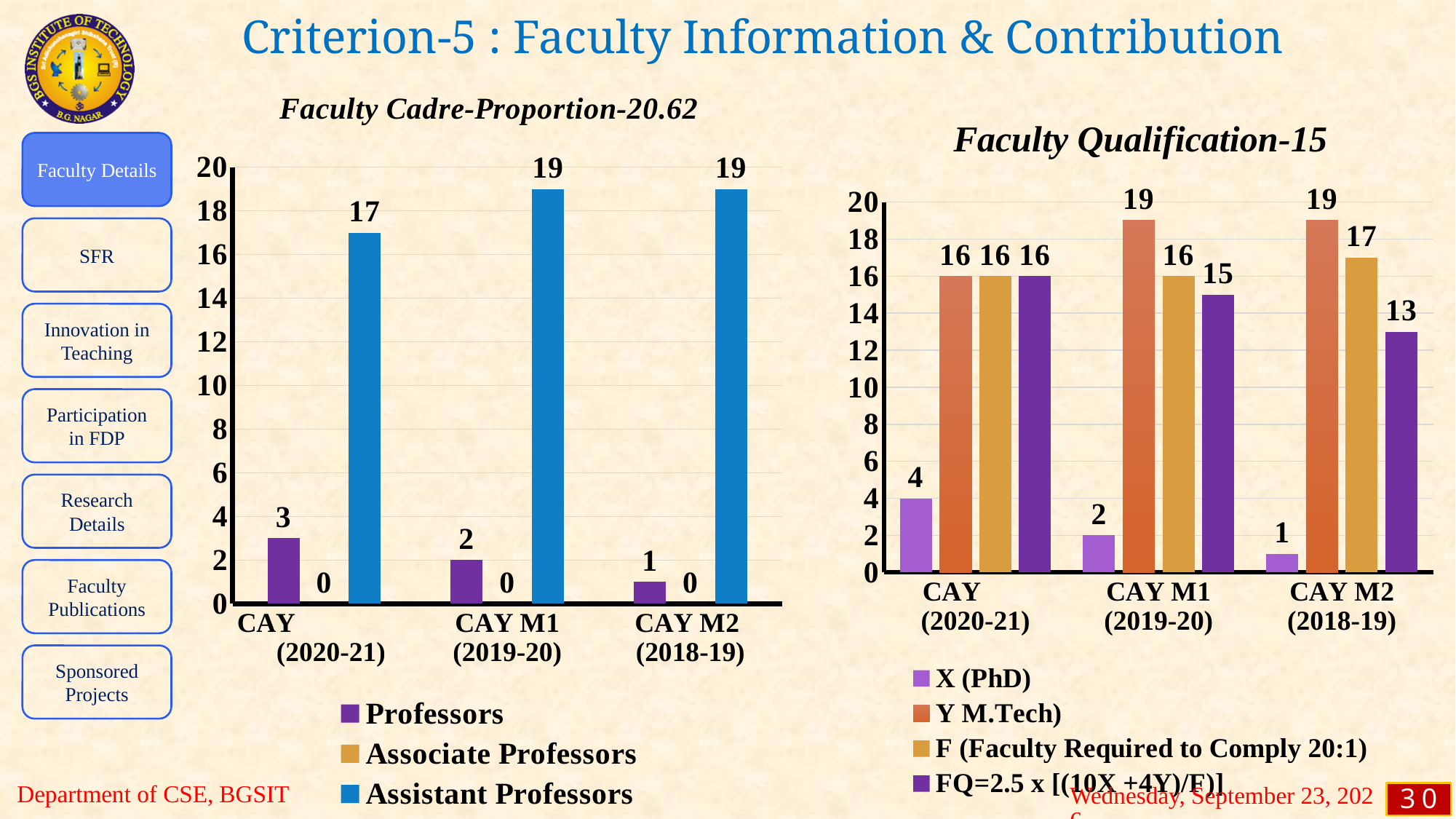
In the Faculty Qualification-15 chart, which category has the lowest X (PhD) value? CAY M2 (2018-19) What type of chart is the Faculty Qualification-15 chart? bar chart In the Faculty Qualification-15 chart, which is larger in CAY M2 (2018-19): F (Faculty Required to Comply 20:1) or FQ? F (Faculty Required to Comply 20:1) In the Faculty Qualification-15 chart, what is the FQ value for CAY M2 (2018-19)? 13 In the Faculty Cadre-Proportion-20.62 chart, what is the value for Professors in CAY M2 (2018-19)? 1 In the Faculty Cadre-Proportion-20.62 chart, what is the value for Associate Professors in CAY M1 (2019-20)? 0 In the Faculty Cadre-Proportion-20.62 chart, how many Assistant Professors are shown for CAY (2020-21)? 17 In the Faculty Qualification-15 chart, what is the value for Y M.Tech) in CAY M1 (2019-20)? 19 In the Faculty Qualification-15 chart, what is the difference between X (PhD) in CAY (2020-21) and X (PhD) in CAY M1 (2019-20)? 2 In the Faculty Cadre-Proportion-20.62 chart, do the Professors values rise or fall from CAY (2020-21) to CAY M2 (2018-19)? fall How many series does the legend of the Faculty Cadre-Proportion-20.62 chart list? 3 In the Faculty Cadre-Proportion-20.62 chart, what is the difference between Assistant Professors and Professors in CAY M1 (2019-20)? 17